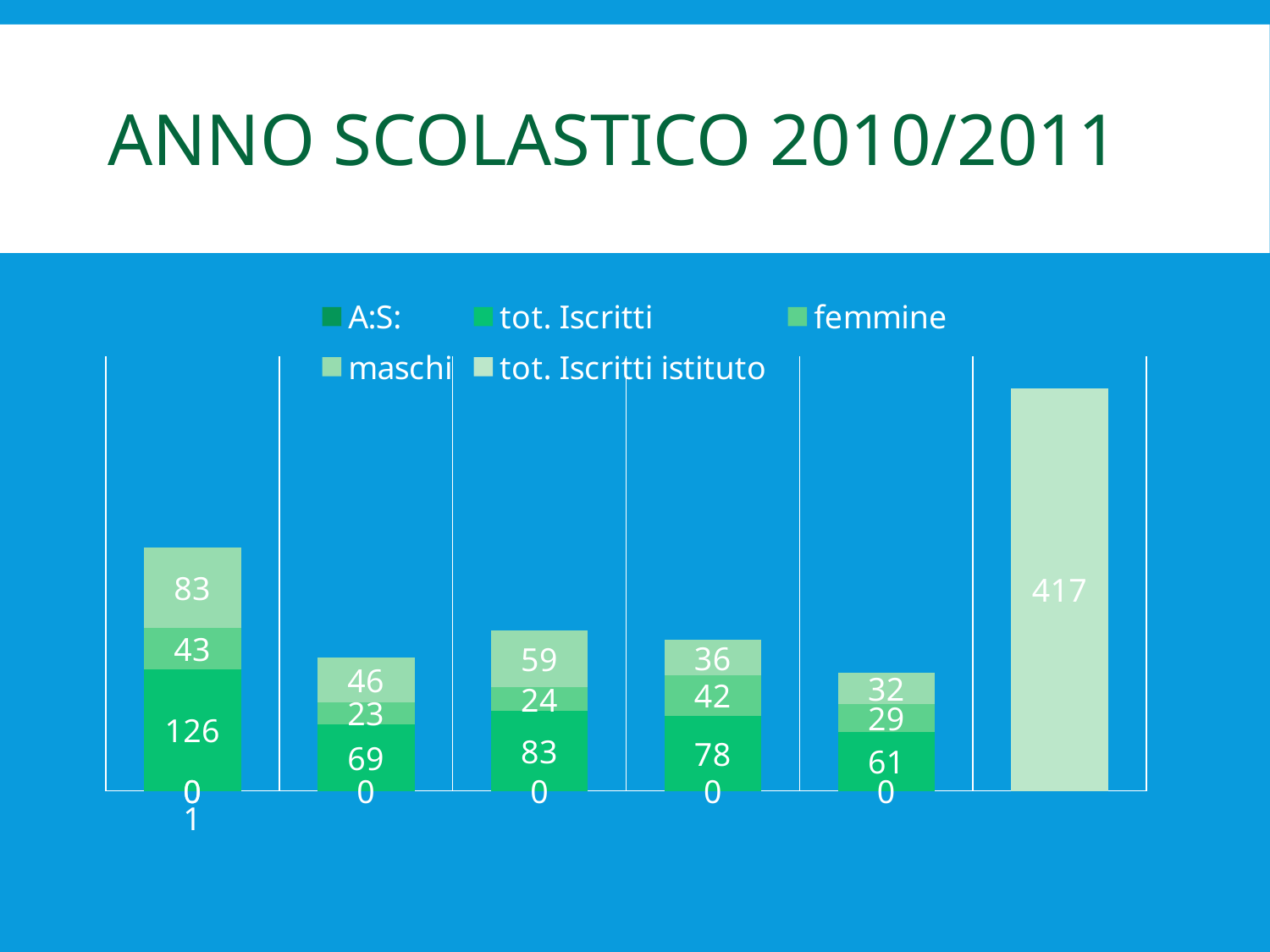
What is the 'maschi' value in the third stacked bar from the left? 59 What is the difference between the 'tot. Iscritti' values of the first bar (126) and the second bar (69)? 57 Among the five stacked bars, which one has the highest 'tot. Iscritti' value? the first (leftmost) bar, 126 What is the title of the slide containing the chart? ANNO SCOLASTICO 2010/2011 How many bars are plotted on the chart? 6 What is the value of the 'tot. Iscritti istituto' bar, the rightmost bar on the chart? 417 Among the five stacked bars, which one has the lowest 'tot. Iscritti' value? the fifth bar, 61 What kind of chart is shown on the slide? stacked bar chart In the fourth stacked bar from the left, which is larger: 'femmine' or 'maschi'? femmine How many series does the chart legend list? 5 What is the 'femmine' value in the fifth stacked bar from the left? 29 What is the 'tot. Iscritti' value in the first (leftmost) stacked bar? 126